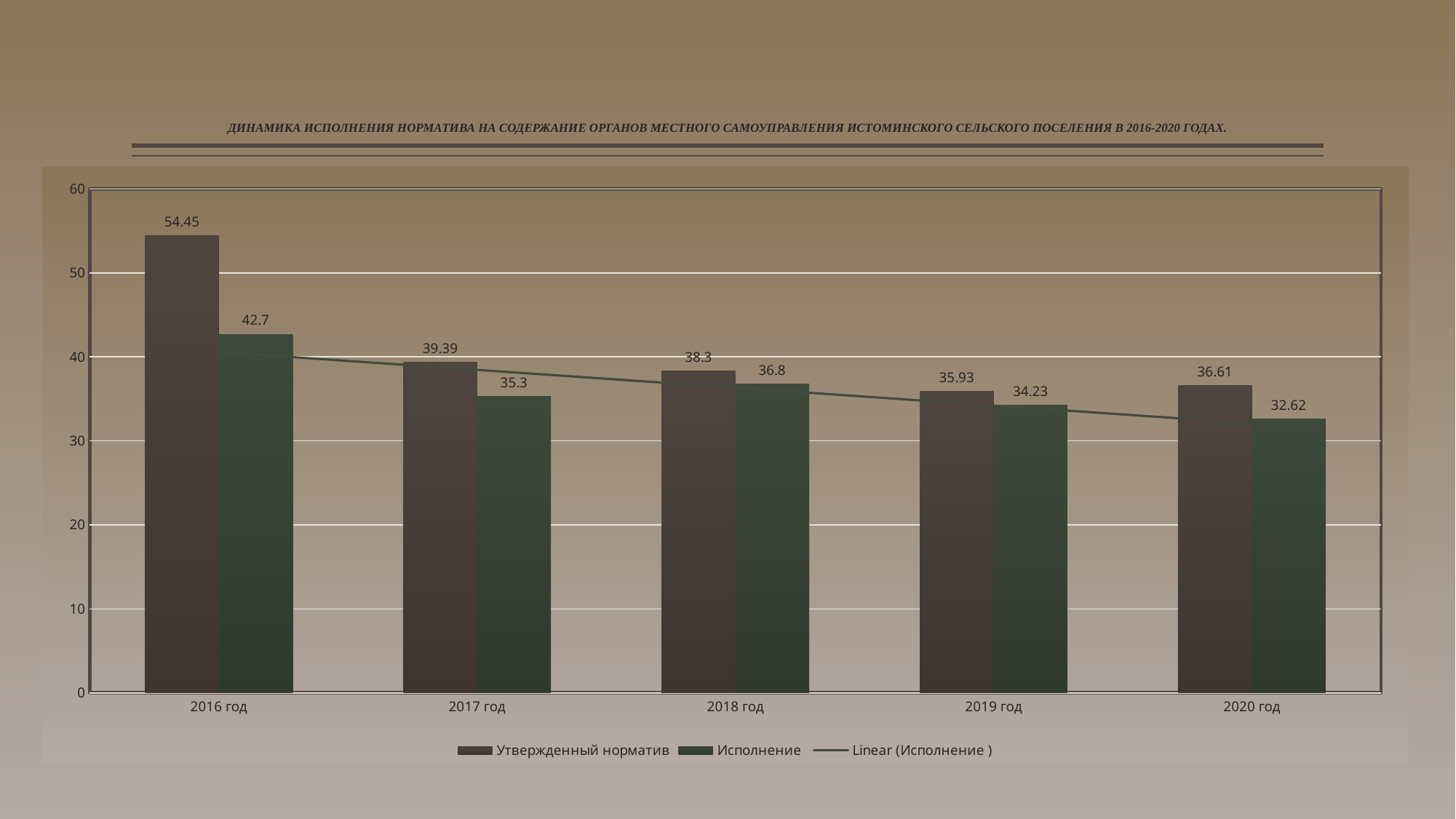
What is the value of Исполнение for 2018 год? 36.8 Which year has the lowest value for Исполнение? 2020 год Is the value of Исполнение for 2017 год greater or less than 40? less What is the value of Исполнение for 2020 год? 32.62 What is the difference between Утвержденный норматив and Исполнение for 2020 год? 3.99 How many entries does the legend list? 3 Which is larger for 2019 год: Утвержденный норматив or Исполнение? Утвержденный норматив Does the Утвержденный норматив series generally rise or fall from 2016 год to 2020 год? fall What is the difference between Утвержденный норматив and Исполнение for 2016 год? 11.75 How many years are shown on the x axis? 5 What is the value of Утвержденный норматив for 2016 год? 54.45 Which year has the highest value for Утвержденный норматив? 2016 год